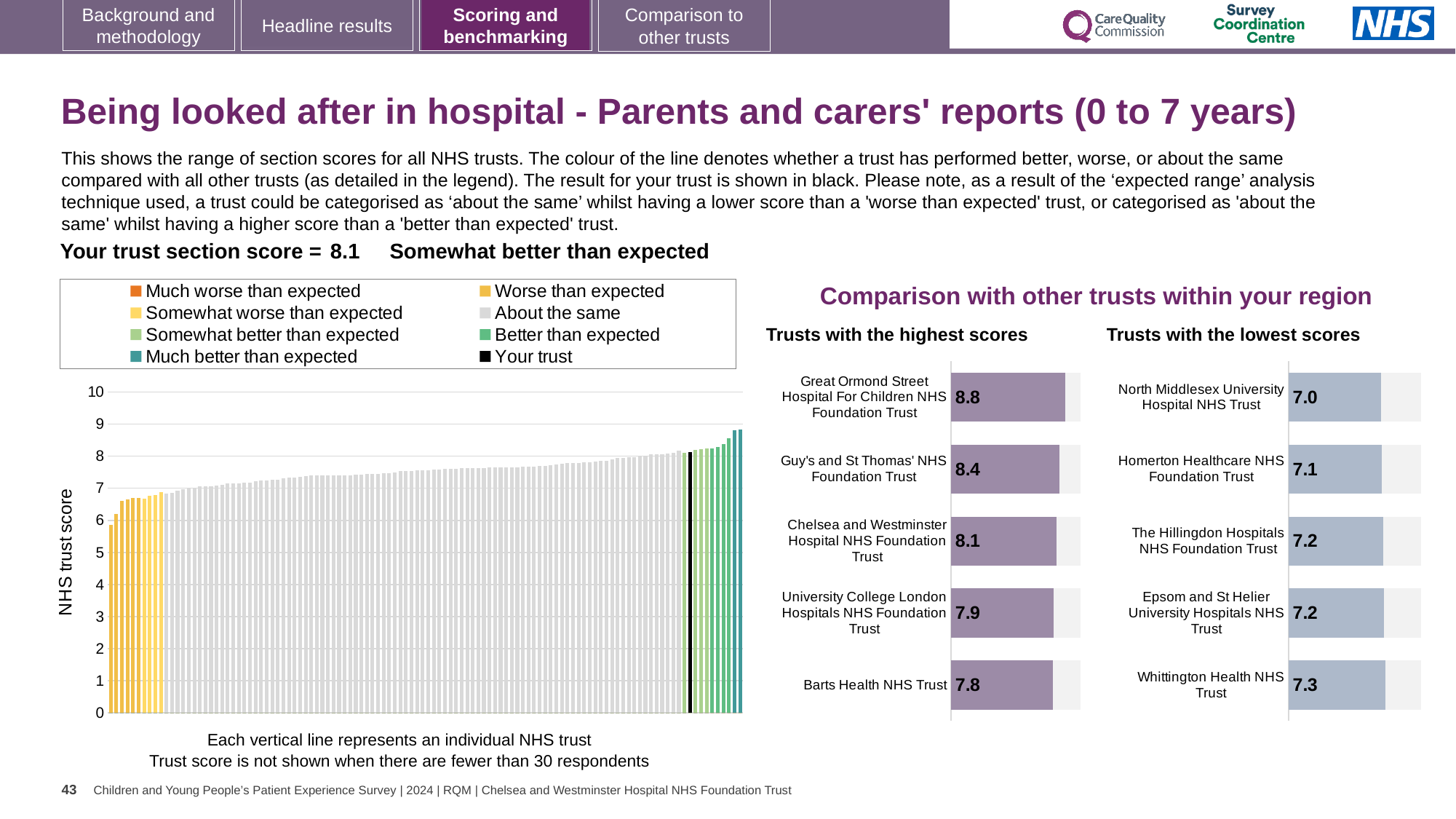
In the 'Trusts with the highest scores' chart, what is the score for Great Ormond Street Hospital For Children NHS Foundation Trust? 8.8 In the NHS trust score chart on the left, do the values rise or fall from left to right? Rise How many entries does the legend of the NHS trust score chart on the left list? 8 In the 'Trusts with the lowest scores' chart, which has the larger score: Homerton Healthcare NHS Foundation Trust or Whittington Health NHS Trust? Whittington Health NHS Trust What kind of chart is the NHS trust score chart on the left of the slide? Bar chart In the 'Trusts with the lowest scores' chart, what is the score for North Middlesex University Hospital NHS Trust? 7.0 How many trusts are shown in the 'Trusts with the highest scores' chart? 5 In the 'Trusts with the highest scores' chart, what is the score for Barts Health NHS Trust? 7.8 In the 'Trusts with the highest scores' chart, which trust has the highest score? Great Ormond Street Hospital For Children NHS Foundation Trust In the 'Trusts with the highest scores' chart, what is the difference between the scores of Great Ormond Street Hospital For Children NHS Foundation Trust and Barts Health NHS Trust? 1.0 In the 'Trusts with the lowest scores' chart, what is the score for Whittington Health NHS Trust? 7.3 In the 'Trusts with the lowest scores' chart, which trust has the lowest score? North Middlesex University Hospital NHS Trust